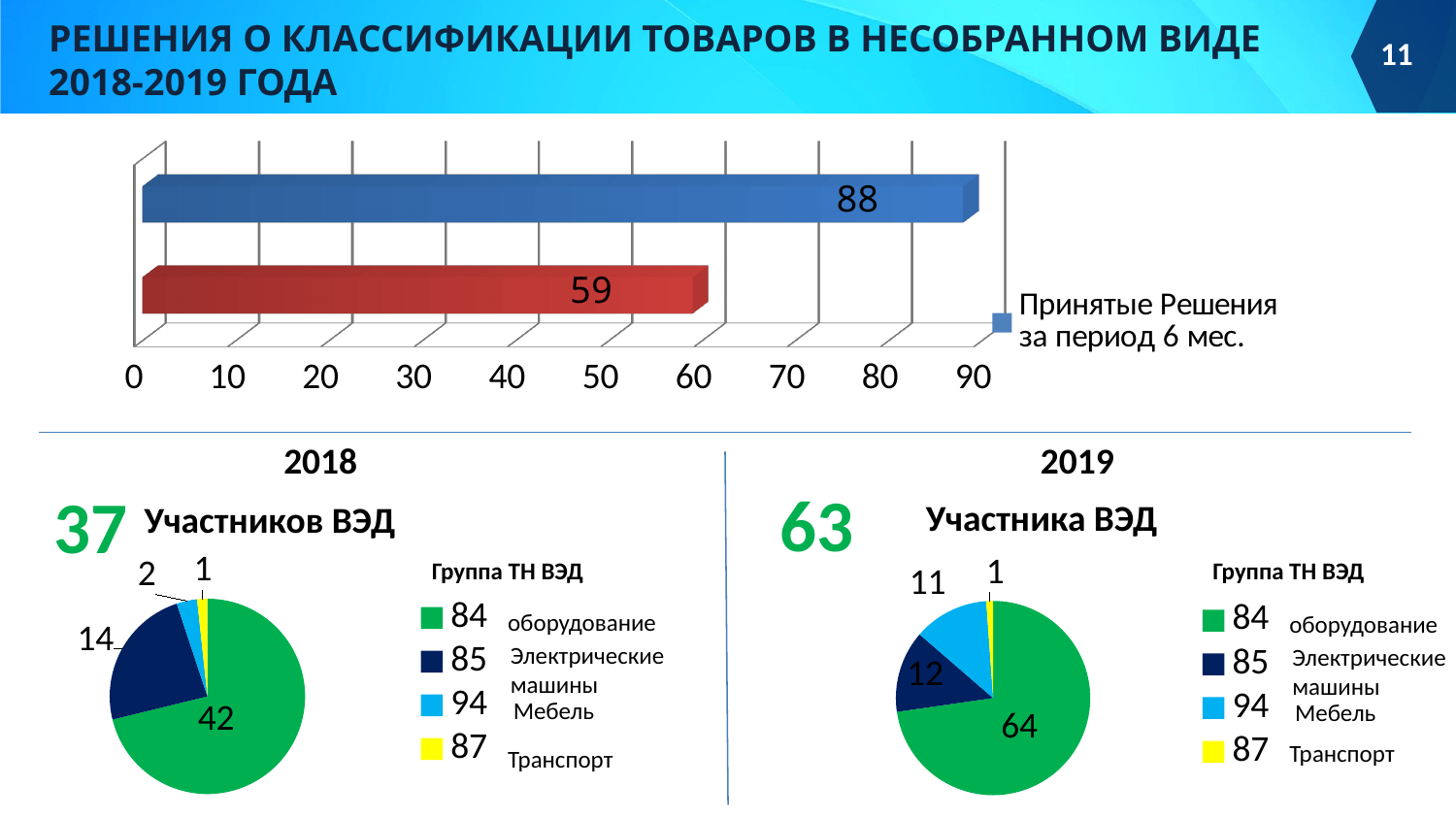
How many slices does the 2018 pie chart have? 4 In the 2018 pie chart, which group has the smallest slice? 87 Транспорт In the top bar chart, what is the difference between the blue bar and the red bar? 29 In the top bar chart, what is the value of the blue (upper) bar? 88 How many bars are plotted in the top bar chart? 2 What does the legend of the top bar chart say? Принятые Решения за период 6 мес. In the 2019 pie chart, what is the value for group 94 (Мебель)? 11 In the 2018 pie chart, what is the value for group 84 (оборудование)? 42 In the top bar chart, what is the value of the red (lower) bar? 59 In the top bar chart, which bar is larger, the blue one or the red one? the blue one In the 2019 pie chart, which group has the largest slice? 84 оборудование What kind of chart is the chart at the top of the slide? bar chart